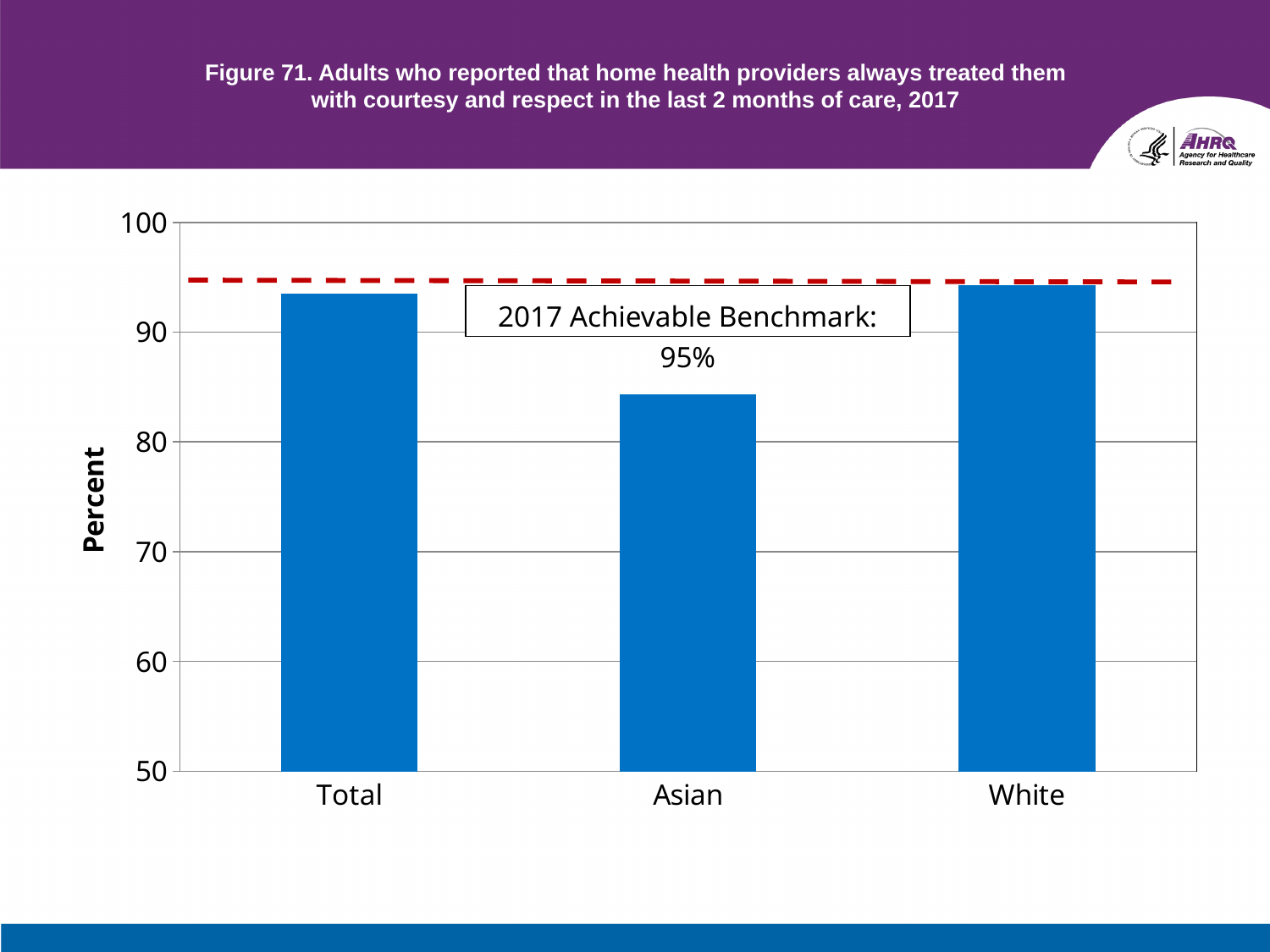
Which category has the lowest value in the chart? Asian What is the figure number in the chart title? Figure 71 Is the value for Total greater or less than 90? greater What is the 2017 Achievable Benchmark shown on the chart? 95% How many categories are shown on the x axis of the chart? 3 Which is larger, the value for Total or the value for Asian? Total What is the label of the y axis? Percent Is the value for Asian greater or less than 80? greater What kind of chart is shown on the slide? bar chart Is the value for Asian greater or less than 90? less Which is larger, the value for Asian or the value for White? White